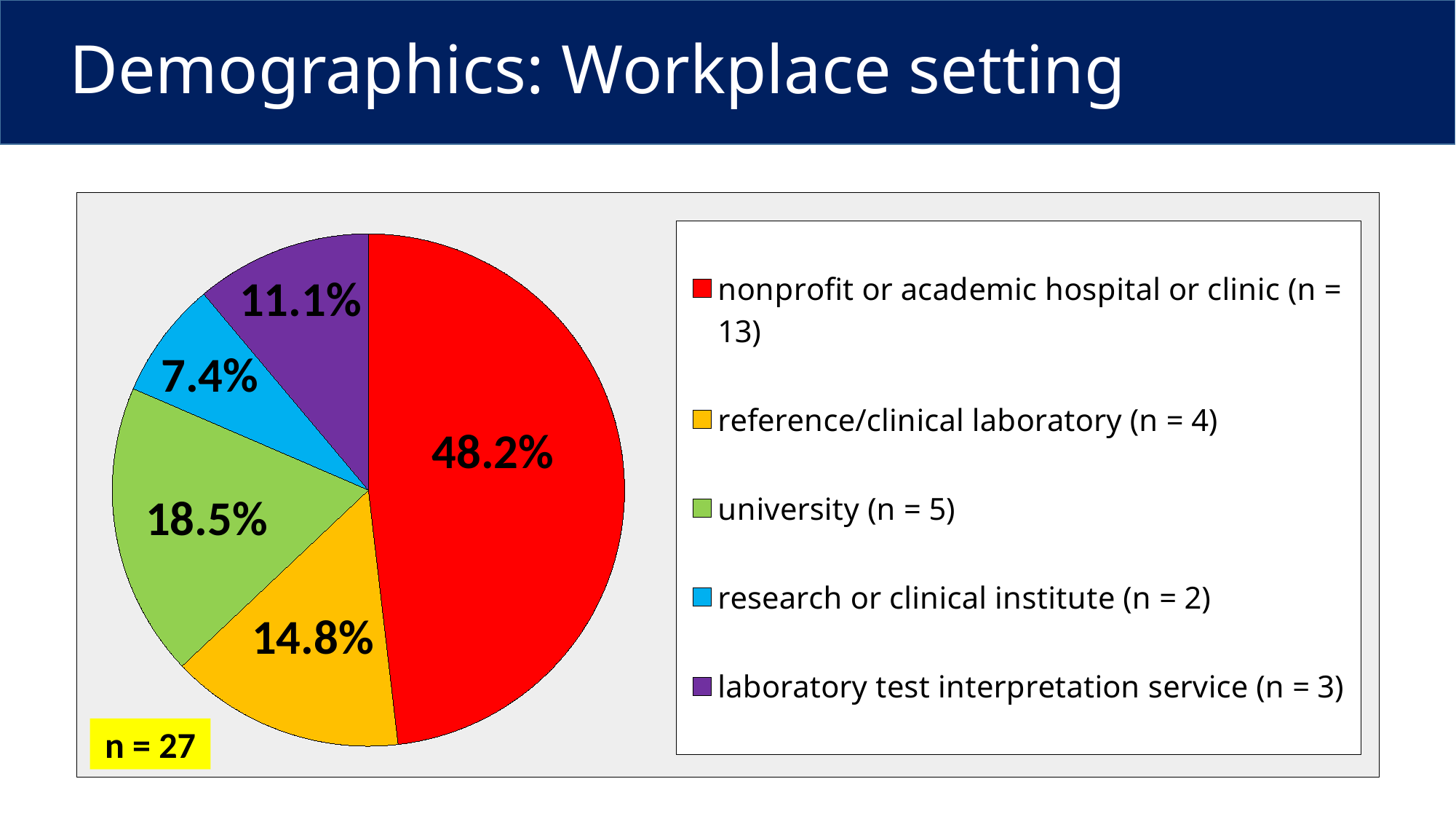
What percentage of respondents work at a university? 18.5% What percentage of respondents work at a nonprofit or academic hospital or clinic? 48.2% What percentage of respondents work at a reference/clinical laboratory? 14.8% Which workplace setting has the largest share of the pie? nonprofit or academic hospital or clinic Which workplace setting has the smallest share of the pie? research or clinical institute How many workplace setting categories are shown in the pie chart? 5 What type of chart is shown on the slide? pie chart What percentage of respondents work at a laboratory test interpretation service? 11.1% Which is larger: the share for laboratory test interpretation service or the share for research or clinical institute? laboratory test interpretation service What is the total number of respondents (n) shown on the chart? n = 27 What percentage of respondents work at a research or clinical institute? 7.4% What is the difference in percentage points between the university slice and the reference/clinical laboratory slice? 3.7